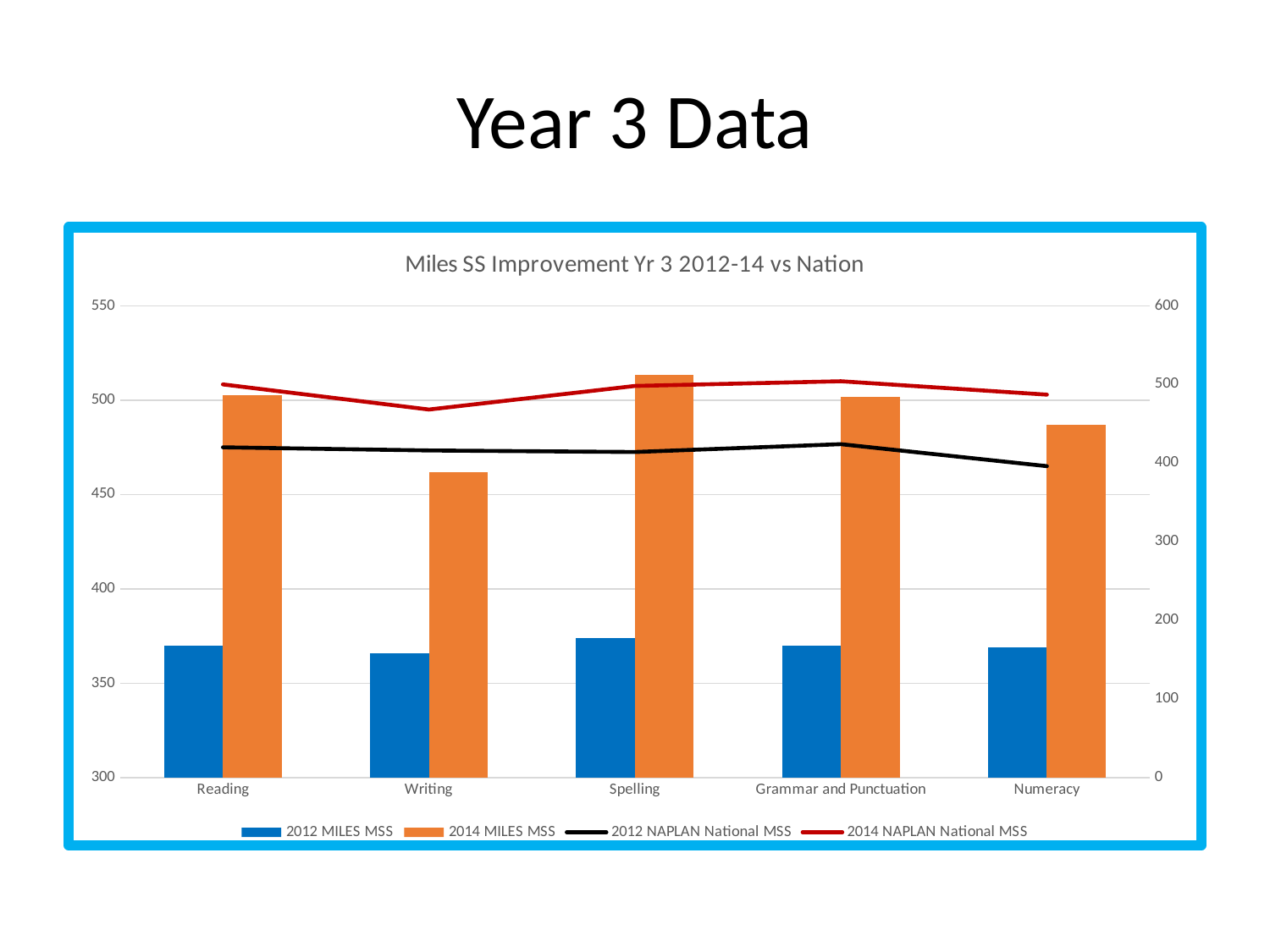
At which category is the 2012 NAPLAN National MSS line at its lowest point? Numeracy Is the 2014 MILES MSS value for Numeracy greater or less than 450? greater Is the 2014 MILES MSS value for Writing greater or less than 500? less What is the title of the chart? Miles SS Improvement Yr 3 2012-14 vs Nation Is the 2012 MILES MSS value for Writing greater or less than 400? less How many series does the legend list? 4 For Writing, which is larger: the 2012 MILES MSS bar or the 2014 MILES MSS bar? 2014 MILES MSS Which category has the highest 2014 MILES MSS bar? Spelling How many categories are shown on the x axis? 5 What kind of chart is this? Combined bar and line chart Which category has the lowest 2014 MILES MSS bar? Writing Does the 2012 NAPLAN National MSS line rise or fall from Grammar and Punctuation to Numeracy? fall